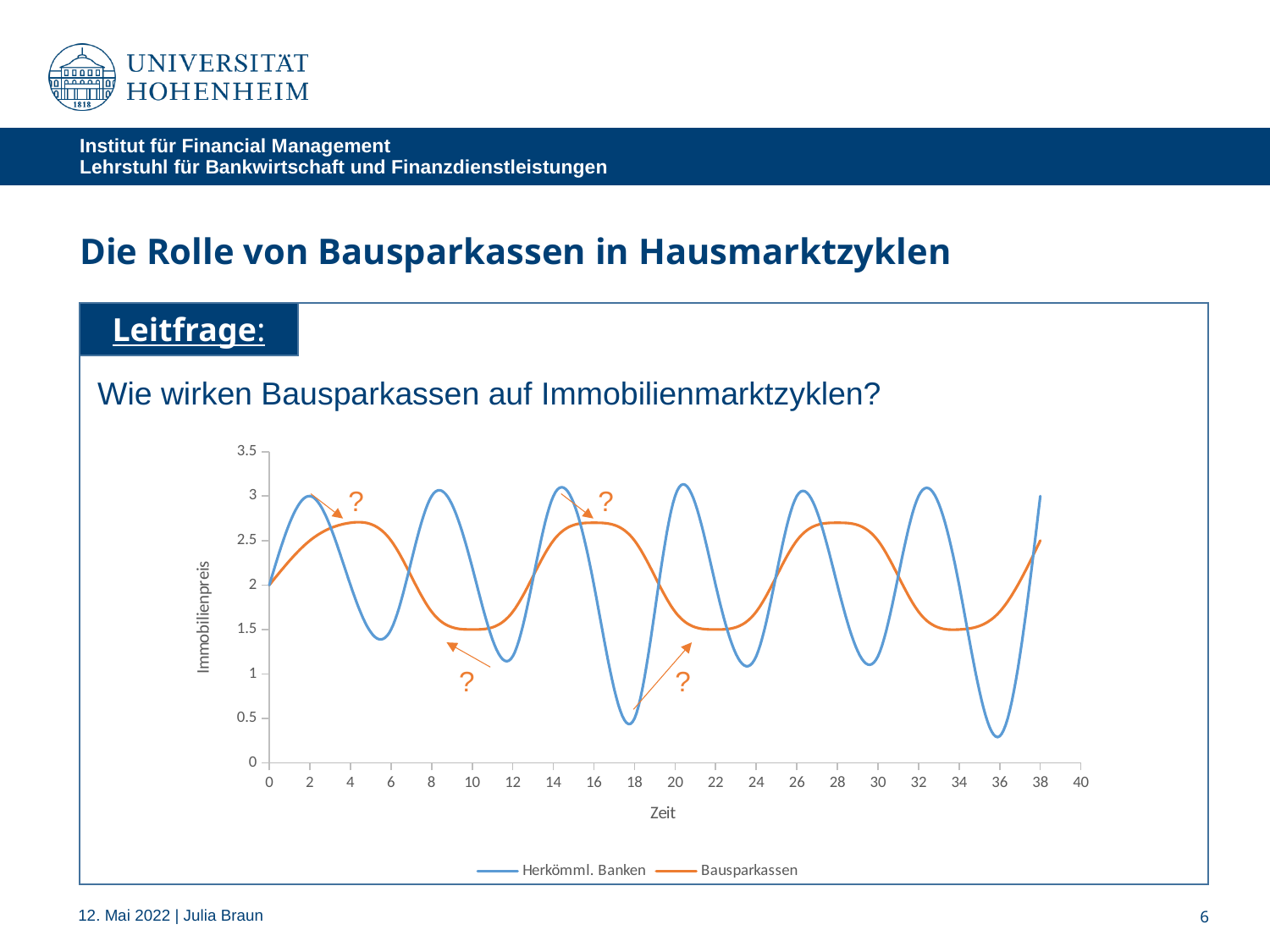
At time 18, which series has the higher Immobilienpreis, Herkömml. Banken or Bausparkassen? Bausparkassen Which series reaches the highest Immobilienpreis anywhere on the chart? Herkömml. Banken Is the highest value reached by the Bausparkassen series greater or less than 2.5? greater Which series shows the larger swings in Immobilienpreis over time? Herkömml. Banken What is the label of the vertical axis of the chart? Immobilienpreis How many series does the chart legend list? 2 Is the lowest value reached by the Herkömml. Banken series greater or less than 1? less At time 8, which series has the higher Immobilienpreis, Herkömml. Banken or Bausparkassen? Herkömml. Banken Which series reaches the lowest Immobilienpreis anywhere on the chart? Herkömml. Banken What are the two series named in the chart legend? Herkömml. Banken and Bausparkassen What kind of chart is shown on the slide? line chart